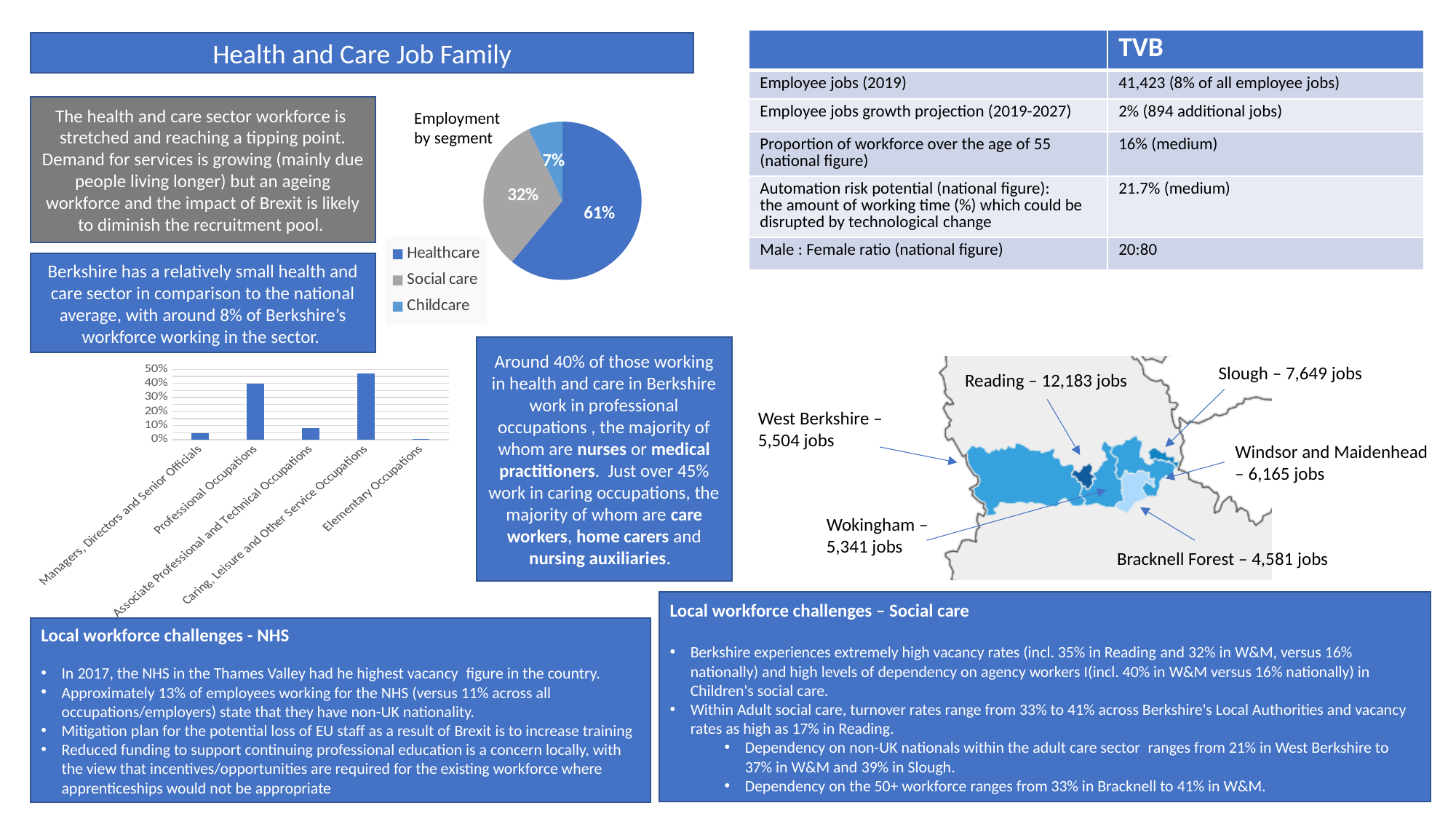
In the bar chart at the bottom left, is the value for Professional Occupations greater or less than 30%? greater How many occupation categories are shown in the bar chart at the bottom left of the slide? 5 In the 'Employment by segment' pie chart, which segment has the smallest share? Childcare In the 'Employment by segment' pie chart, how many percentage points larger is Healthcare than Social care? 29 percentage points In the 'Employment by segment' pie chart, what share of employment is Healthcare? 61% In the bar chart at the bottom left, which is larger: Managers, Directors and Senior Officials or Associate Professional and Technical Occupations? Associate Professional and Technical Occupations In the 'Employment by segment' pie chart, what share of employment is Social care? 32% In the 'Employment by segment' pie chart, what share of employment is Childcare? 7% In the 'Employment by segment' pie chart, which segment has the largest share? Healthcare What kind of chart is the occupations chart at the bottom left of the slide? Bar chart How many segments does the legend of the 'Employment by segment' pie chart list? 3 In the bar chart at the bottom left, which occupation category has the highest value? Caring, Leisure and Other Service Occupations